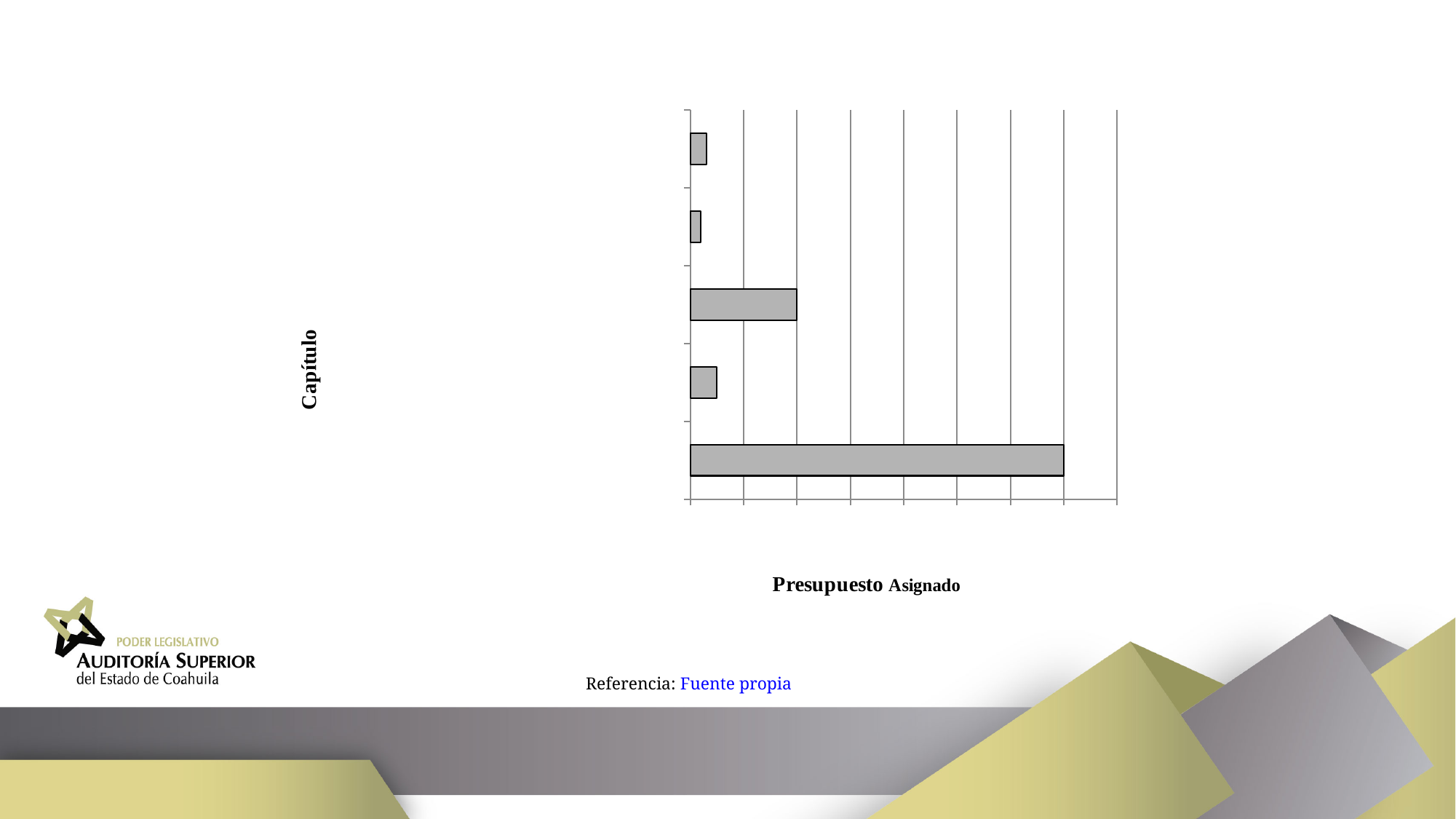
What is the title of the horizontal axis of the chart? Presupuesto Asignado Which bar is the longest in the chart, counting from the top? the fifth (bottom) bar Is the third bar from the top longer or shorter than the fourth bar from the top? longer Which bar is the shortest in the chart, counting from the top? the second bar Is the first (top) bar longer or shorter than the bottom bar? shorter What is the title of the vertical axis of the chart? Capítulo How many bars are plotted in the chart? 5 What kind of chart is shown on the slide? bar chart